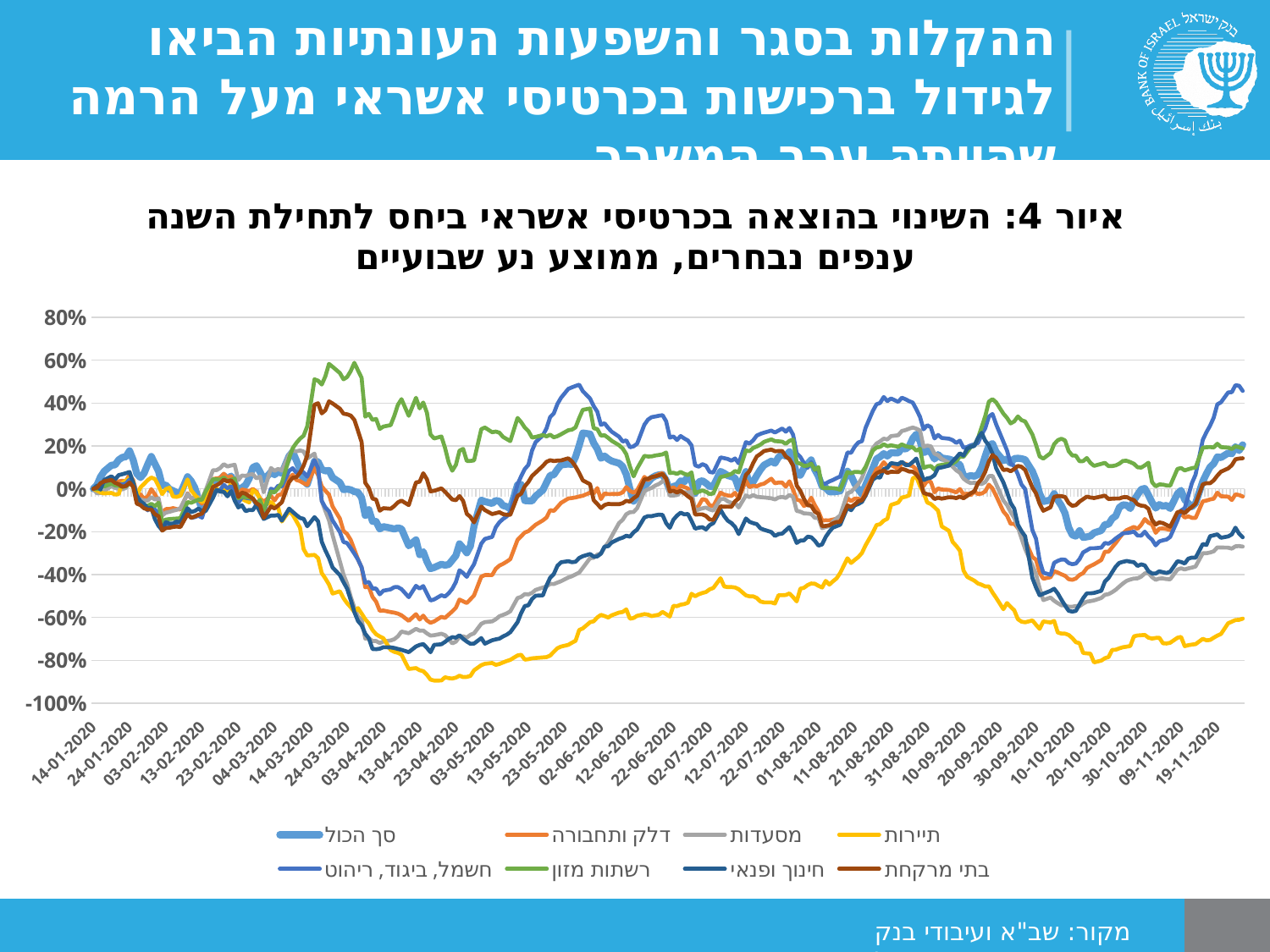
Does the value for תיירות rise or fall between 04-03-2020 and 13-04-2020? fall What is the title of the chart? איור 4: השינוי בהוצאה בכרטיסי אשראי ביחס לתחילת השנה ענפים נבחרים, ממוצע נע שבועיים Around 13-04-2020, which is larger: the value for רשתות מזון or the value for מסעדות? רשתות מזון Is the value for רשתות מזון around 24-03-2020 greater or less than 40%? greater What kind of chart is shown on the slide? line chart Which series has the lowest value around 13-04-2020? תיירות Which series has the lowest value at 19-11-2020? תיירות Is the value for תיירות at 19-11-2020 greater or less than -40%? less Is the value for תיירות around 13-04-2020 greater or less than -60%? less Which series is drawn in yellow in the legend? תיירות How many series does the legend list? 8 Which series has the highest value around 24-03-2020? רשתות מזון